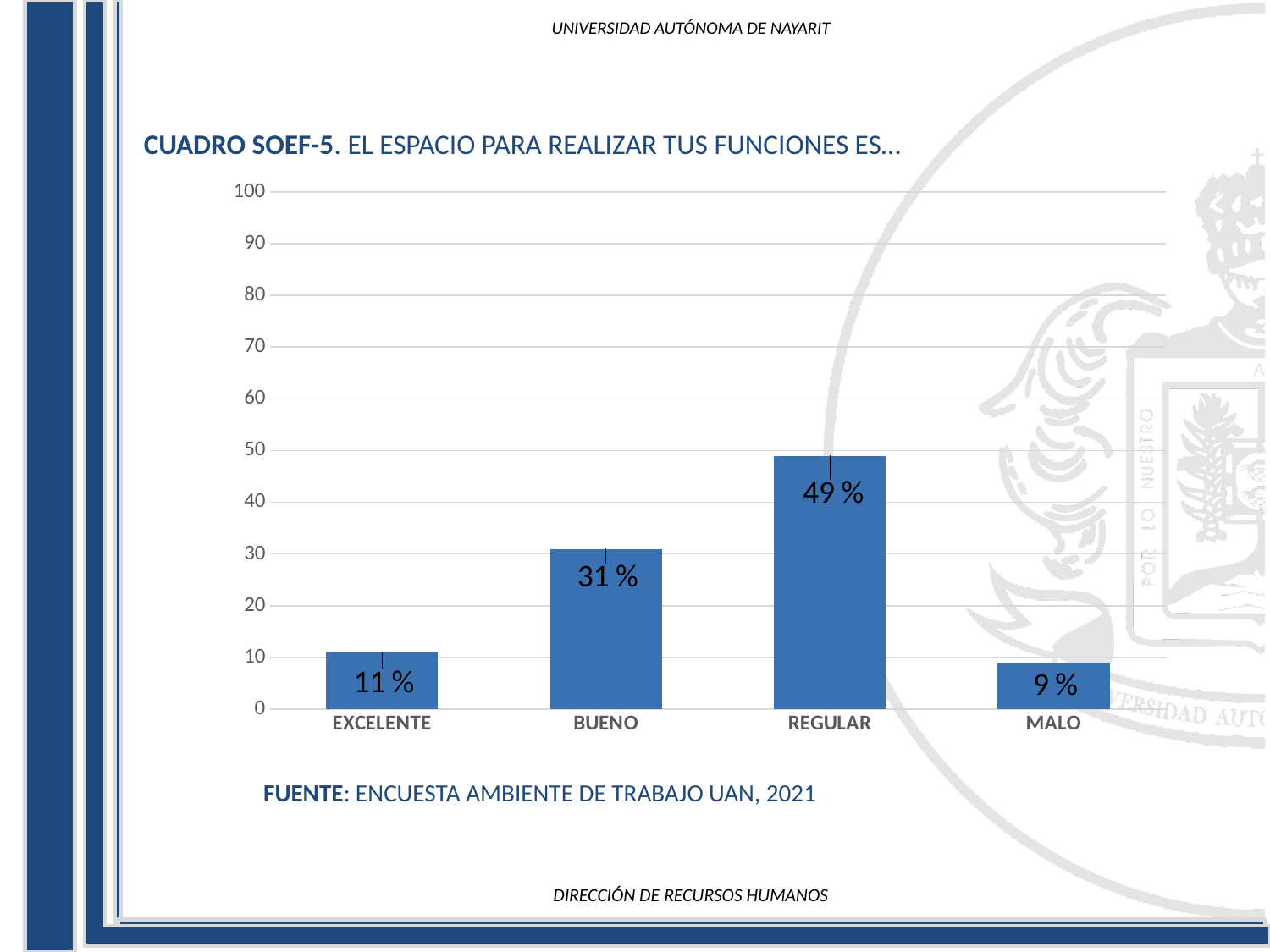
What is the source cited below the chart? ENCUESTA AMBIENTE DE TRABAJO UAN, 2021 Which category has the highest value? REGULAR How many categories are shown on the x axis? 4 What is the value for EXCELENTE? 11 % What is the value for MALO? 9 % What kind of chart is shown on the slide? bar chart Which category has the lowest value? MALO What is the difference between the values for REGULAR and BUENO? 18 % What is the value for REGULAR? 49 % Is the value for BUENO greater or less than 40? less Which is larger, the value for EXCELENTE or the value for MALO? EXCELENTE What is the value for BUENO? 31 %